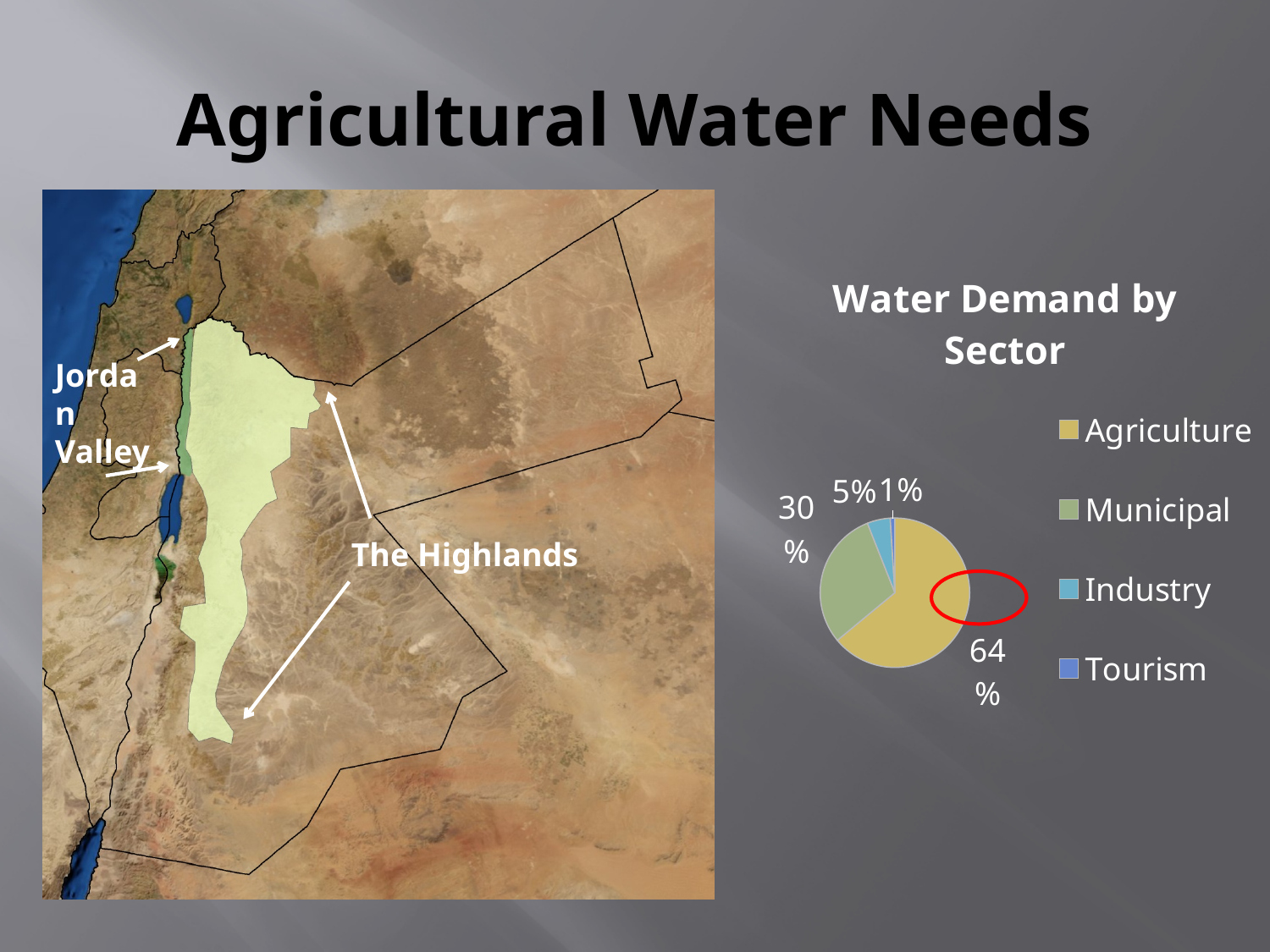
Which slice of the pie is circled in red? Agriculture What share of water demand does Industry account for? 5% How many sectors does the legend list? 4 What kind of chart is shown on the slide? pie chart What is the difference between the Agriculture and Municipal shares? 34% Which sector has the largest share of water demand? Agriculture What share of water demand does Municipal account for? 30% What is the title of the chart? Water Demand by Sector What share of water demand does Tourism account for? 1% Which is larger, the Municipal share or the Industry share? Municipal What share of water demand does Agriculture account for? 64% Which sector has the smallest share of water demand? Tourism